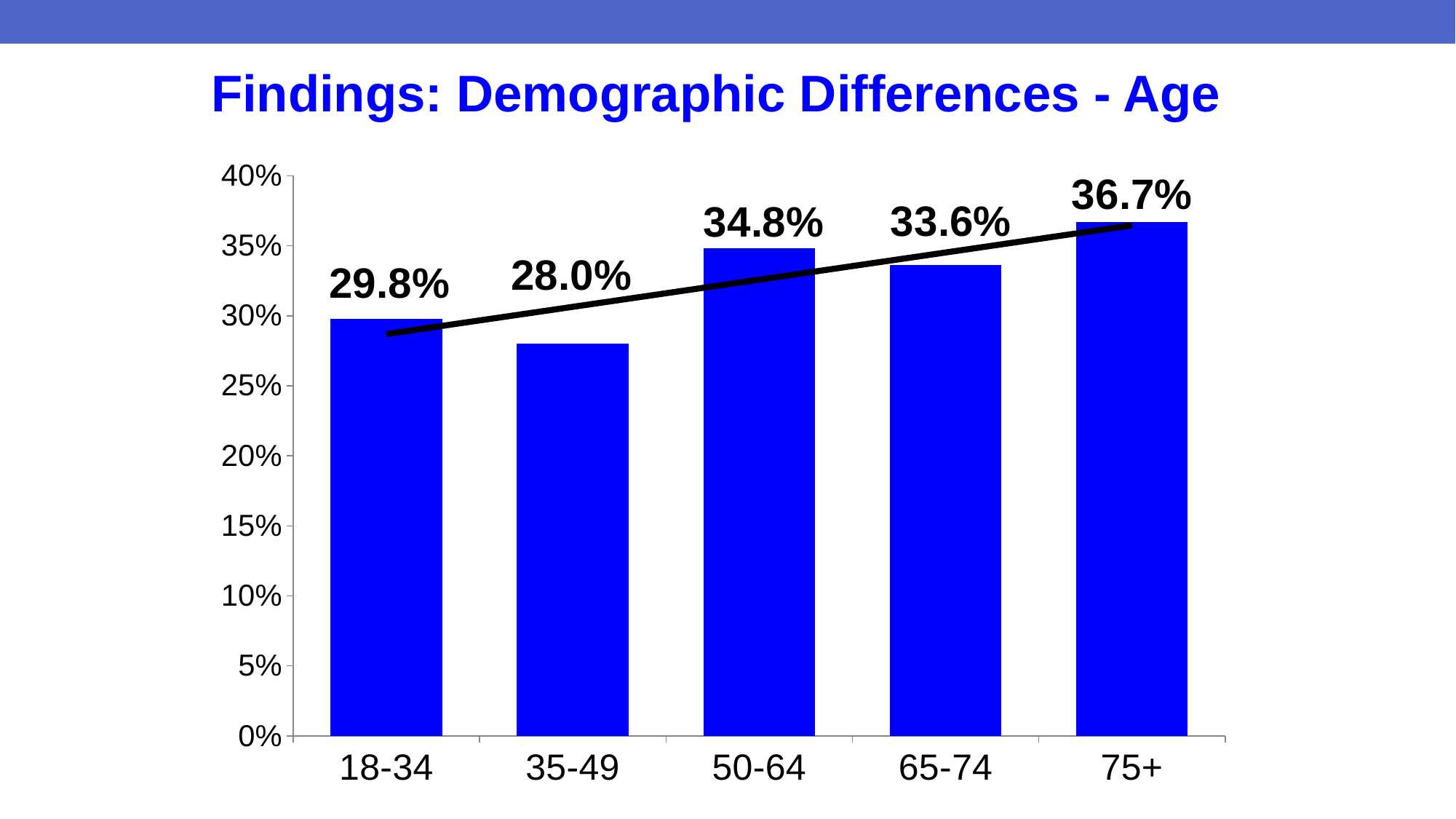
What is the difference between the values for 75+ and 35-49? 8.7% What kind of chart is shown on the slide? bar chart What is the title of the slide? Findings: Demographic Differences - Age Which age group has the lowest value? 35-49 Is the value for 65-74 greater or less than 30%? greater What is the value for the 75+ age group? 36.7% What is the value for the 50-64 age group? 34.8% How many age groups are shown on the chart? 5 What is the value for the 18-34 age group? 29.8% Which age group has the highest value? 75+ Which is larger, the value for 18-34 or the value for 35-49? 18-34 What is the difference between the values for 50-64 and 65-74? 1.2%